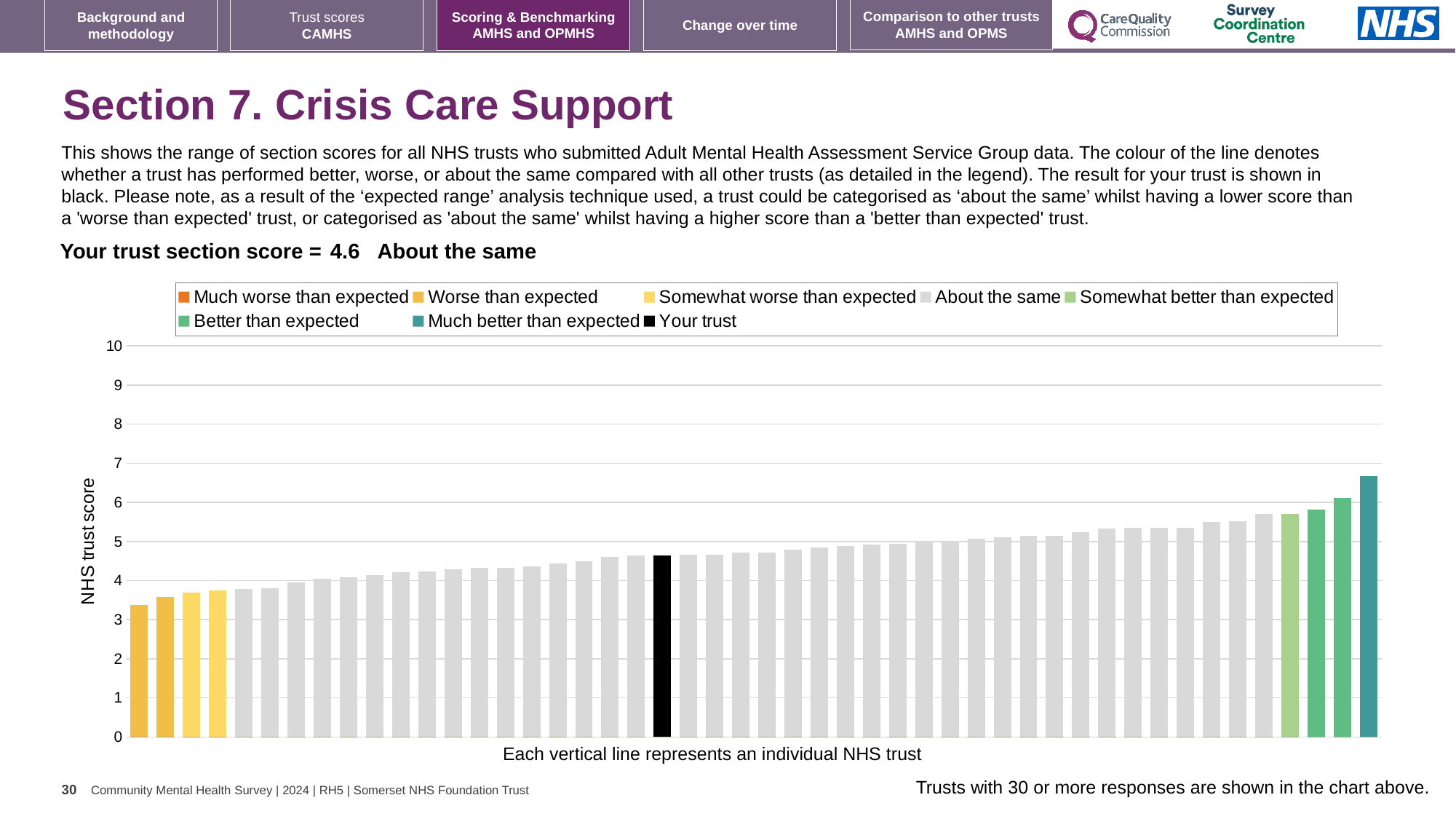
Do the bar values rise or fall from left to right along the x axis? rise What is the section score for your trust shown on the slide? 4.6 How many entries does the chart legend list? 8 Which legend category does the lowest bar in the chart belong to? Worse than expected What kind of chart is shown on the slide? bar chart Which performance category is your trust placed in for Crisis Care Support? About the same Is the value of the lowest bar in the chart greater or less than 3? greater Is the value of the lowest bar in the chart greater or less than 4? less Is the value for your trust (the black bar) greater or less than 5? less Which legend category does the highest bar in the chart belong to? Much better than expected What is the label on the vertical axis of the chart? NHS trust score